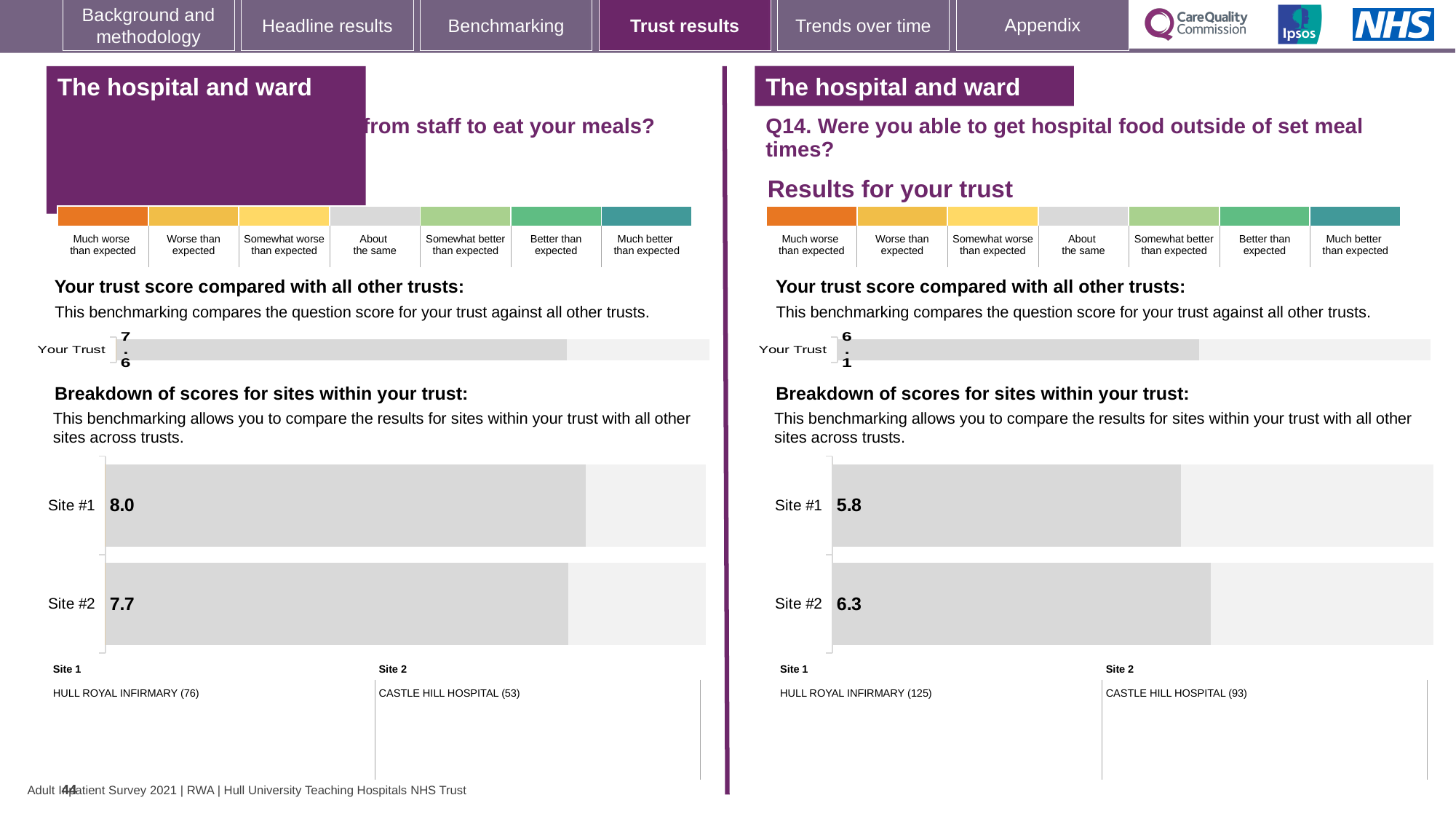
On the right-hand chart for Q14 (hospital food outside of set meal times), what is the score for Site #1? 5.8 On the left-hand site breakdown chart, what is the score for Site #1? 8.0 On the left-hand site breakdown chart, which site has the lower score? Site #2 How many sites are shown in the right-hand site breakdown chart for Q14? 2 On the right-hand side for Q14, what is the 'Your Trust' score? 6.1 What type of chart is used for the site breakdown on the right-hand side? Bar chart On the right-hand chart for Q14, which site has the higher score? Site #2 On the left-hand site breakdown chart, what is the difference between the Site #1 and Site #2 scores? 0.3 On the right-hand chart for Q14, what is the score for Site #2? 6.3 On the right-hand chart for Q14, what is the difference between the Site #2 and Site #1 scores? 0.5 On the left-hand site breakdown chart, what is the score for Site #2? 7.7 On the left-hand side, what is the 'Your Trust' score? 7.6